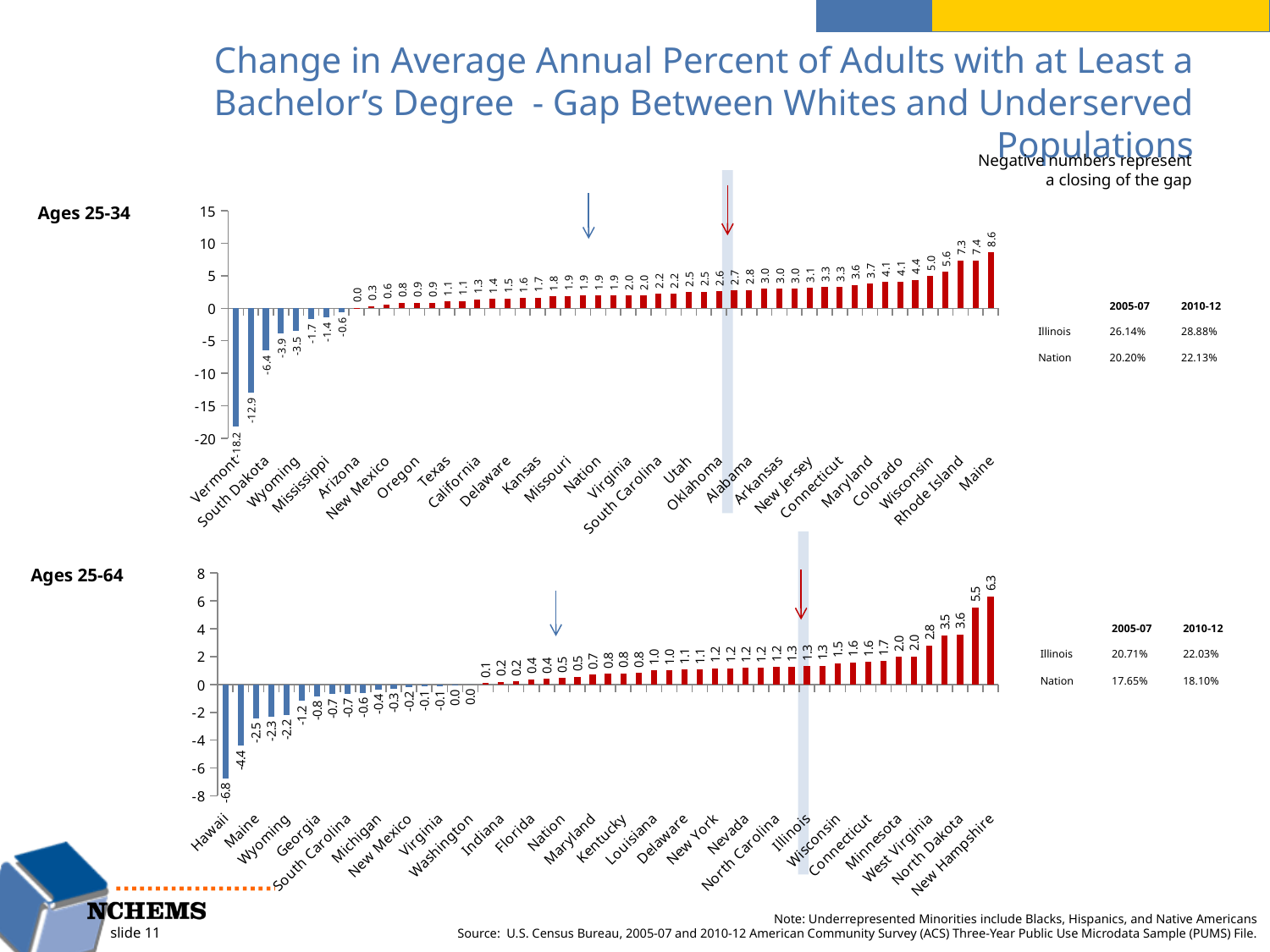
In the Ages 25-64 chart, which state has the highest value? New Hampshire In the Ages 25-64 chart, is the value for Hawaii greater or less than -4? less What kind of chart is used for the Ages 25-34 data? bar chart In the Ages 25-34 chart, what is the value for Vermont? -18.2 In the Ages 25-64 chart, what is the difference between the values for New Hampshire and Hawaii? 13.1 In the Ages 25-34 chart, which state has the lowest value? Vermont In the Ages 25-64 chart, which state has the lowest value? Hawaii In the Ages 25-34 chart, do the values rise or fall moving from left to right along the x axis? rise In the Ages 25-64 chart, what is the value for New Hampshire? 6.3 In the Ages 25-34 chart, what is the value for Maine? 8.6 In the Ages 25-34 chart, which state has the highest value? Maine In the Ages 25-64 chart, what is the value for Hawaii? -6.8